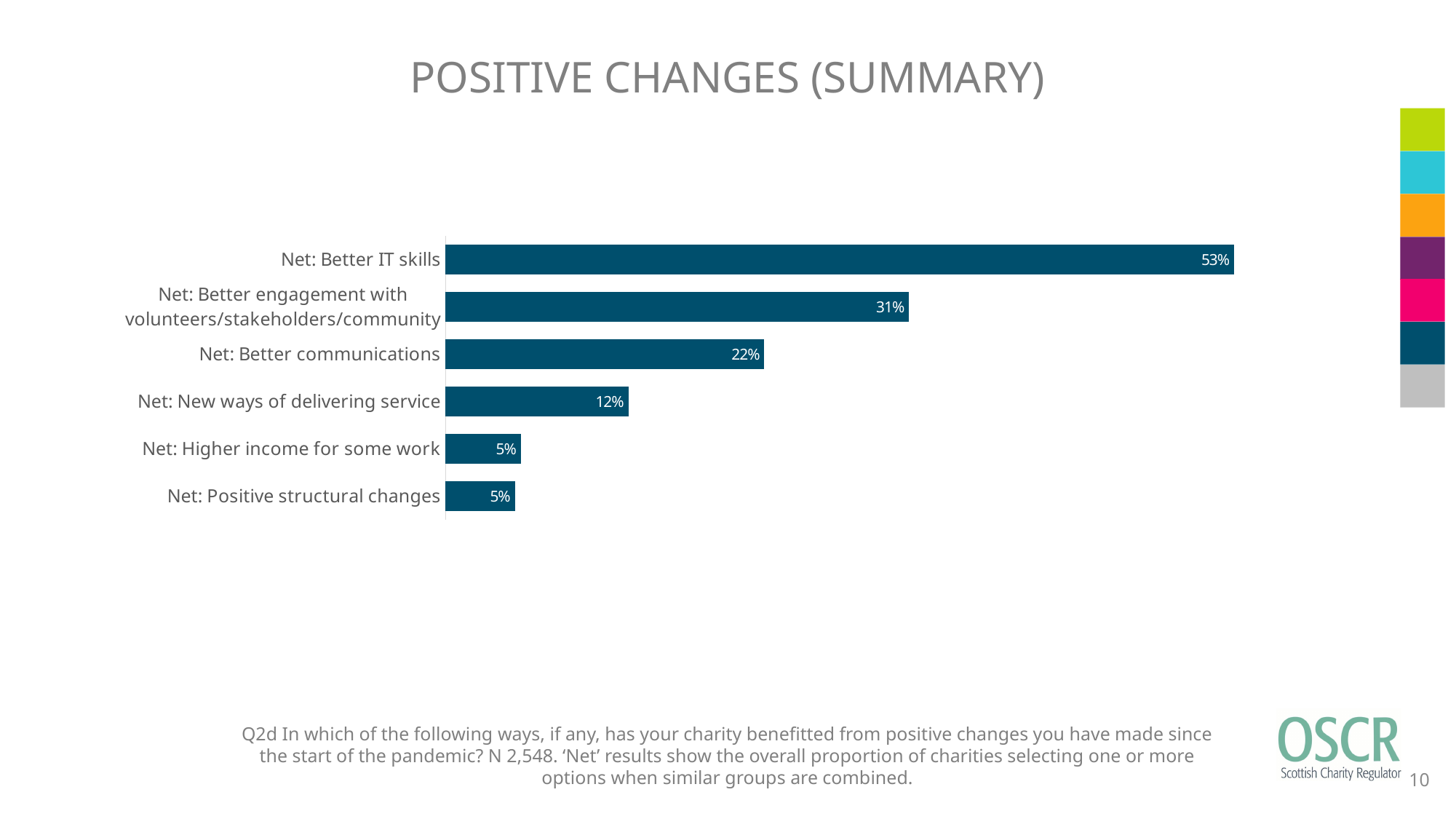
Which category has the highest value? Net: Better IT skills What is the value for Net: Better IT skills? 53% What is the value for Net: Higher income for some work? 5% What is the difference between the values for Net: Better IT skills and Net: Better engagement with volunteers/stakeholders/community? 22% What is the value for Net: Better communications? 22% What kind of chart is shown on the slide? Bar chart What is the difference between the values for Net: Better communications and Net: New ways of delivering service? 10% Which is larger, the value for Net: Better communications or the value for Net: New ways of delivering service? Net: Better communications What is the title of the slide? POSITIVE CHANGES (SUMMARY) What is the value for Net: New ways of delivering service? 12% What is the value for Net: Better engagement with volunteers/stakeholders/community? 31% How many categories are shown in the chart? 6